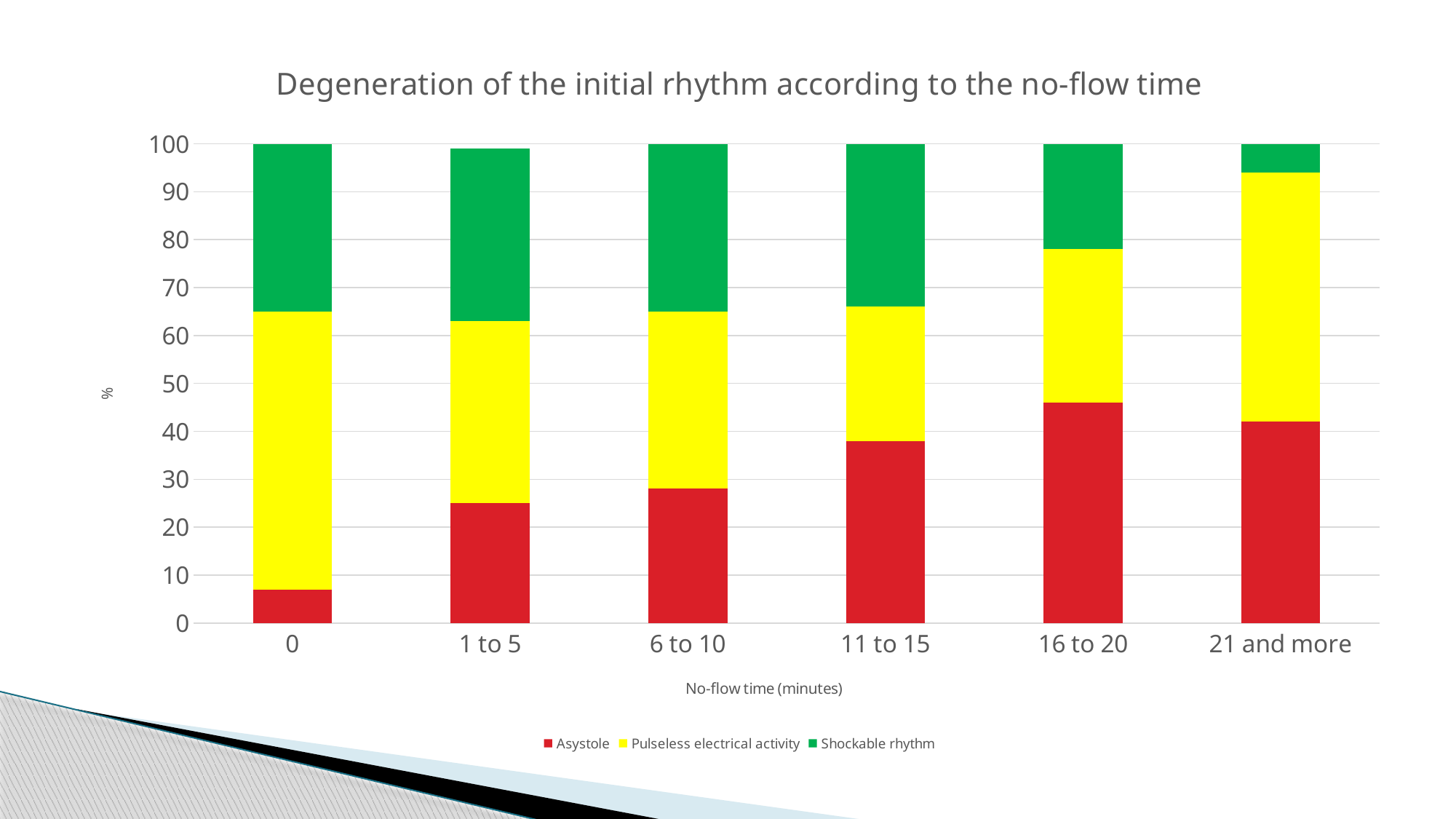
Which no-flow time category has the smallest Shockable rhythm share? 21 and more Is the Asystole value for the 1 to 5 minutes category greater or less than 30? less How many no-flow time categories are shown on the x axis? 6 Which no-flow time category has the smallest Asystole share? 0 Does the Shockable rhythm share rise or fall as no-flow time increases along the x axis? Fall Is the Asystole value for the 16 to 20 minutes category greater or less than 40? greater What is the title of the chart? Degeneration of the initial rhythm according to the no-flow time Which no-flow time category has the largest Asystole share? 16 to 20 What kind of chart is shown on the slide? Stacked bar chart Is the Asystole value for the 0 minutes category greater or less than 10? less Which has the larger Shockable rhythm share: the 0 category or the 21 and more category? 0 How many series does the legend list? 3